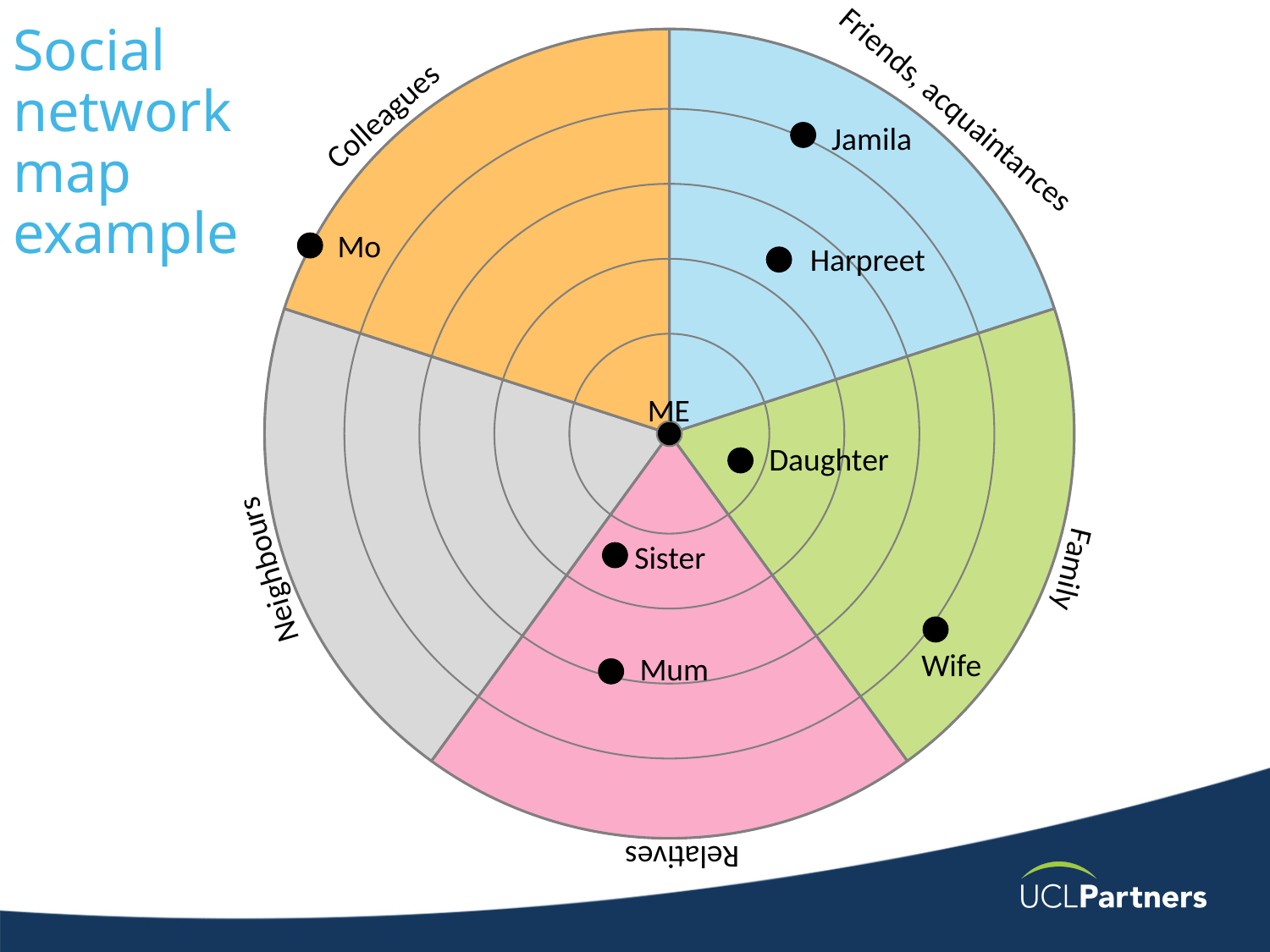
Who is plotted closer to ME, Sister or Mum? Sister Who is plotted closer to ME, Daughter or Wife? Daughter How many sectors (categories) is the circle divided into? 5 What is the title of the slide? Social network map example How many named people are plotted on the map (excluding ME)? 7 Which person is plotted closest to ME? Daughter Which sector is Mo plotted in? Colleagues Who is plotted farther from ME, Jamila or Harpreet? Jamila Which sector has no people plotted in it? Neighbours Which sector contains Sister and Mum? Relatives What label is at the centre of the map? ME Which sector contains Jamila and Harpreet? Friends, acquaintances